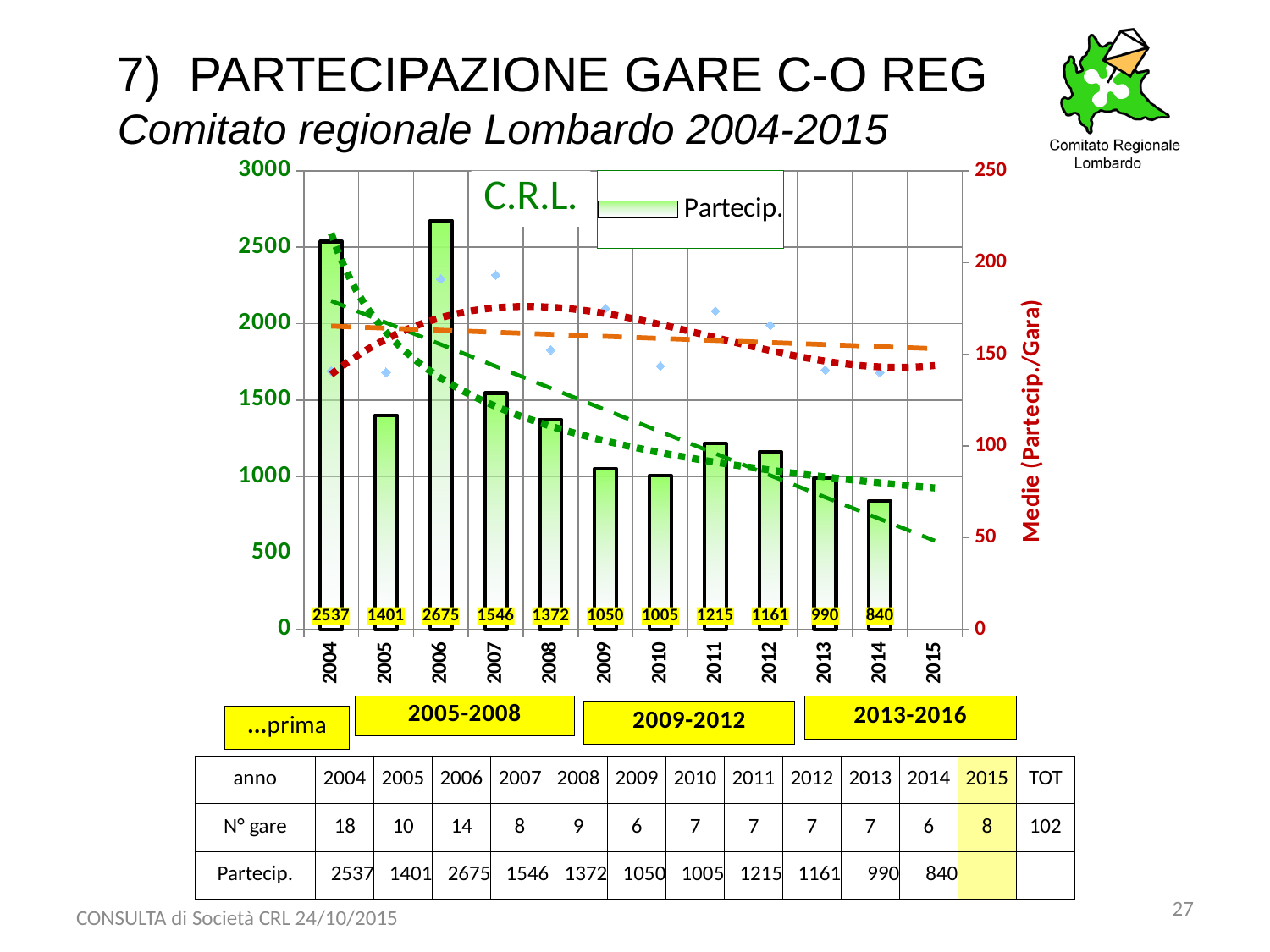
What is the difference between the Partecip. values for 2004 and 2005? 1136 Do the Partecip. bars generally rise or fall from 2004 to 2014? fall What is the Partecip. value for 2006? 2675 How many years have a Partecip. bar plotted in the chart? 11 What is the Partecip. value for 2010? 1005 What is the label of the right-hand vertical axis of the chart? Medie (Partecip./Gara) Which year has a larger Partecip. value, 2011 or 2012? 2011 Which year has the lowest Partecip. bar? 2014 What is the Partecip. value for 2014? 840 What kind of chart is used to show the Partecip. values? bar chart Is the Partecip. value for 2007 greater or less than 1500? greater Which year has the highest Partecip. bar? 2006